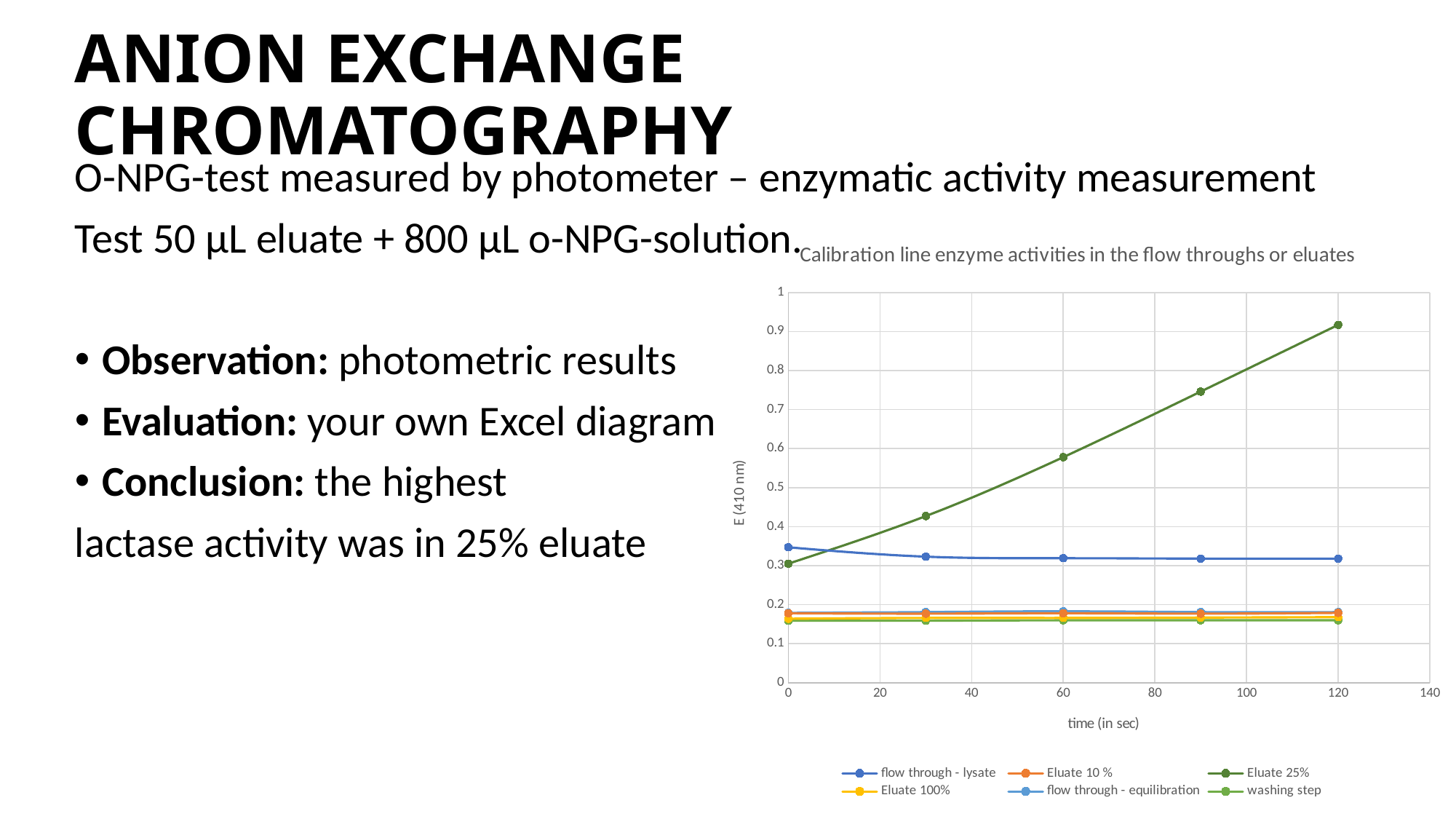
How many series does the chart legend list? 6 What is the label of the x axis of the chart? time (in sec) Is the value for flow through - lysate at 0 seconds greater or less than 0.3? greater Which series has the highest value at 120 seconds? Eluate 25% At 120 seconds, which is larger: Eluate 25% or flow through - lysate? Eluate 25% How many data points are plotted for the Eluate 25% series? 5 Is the value for Eluate 25% at 120 seconds greater or less than 0.8? greater What is the title of the chart? Calibration line enzyme activities in the flow throughs or eluates Is the value for Eluate 25% at 60 seconds greater or less than 0.5? greater Does the Eluate 25% series rise or fall as time increases? rise What kind of chart is shown on the slide? line chart